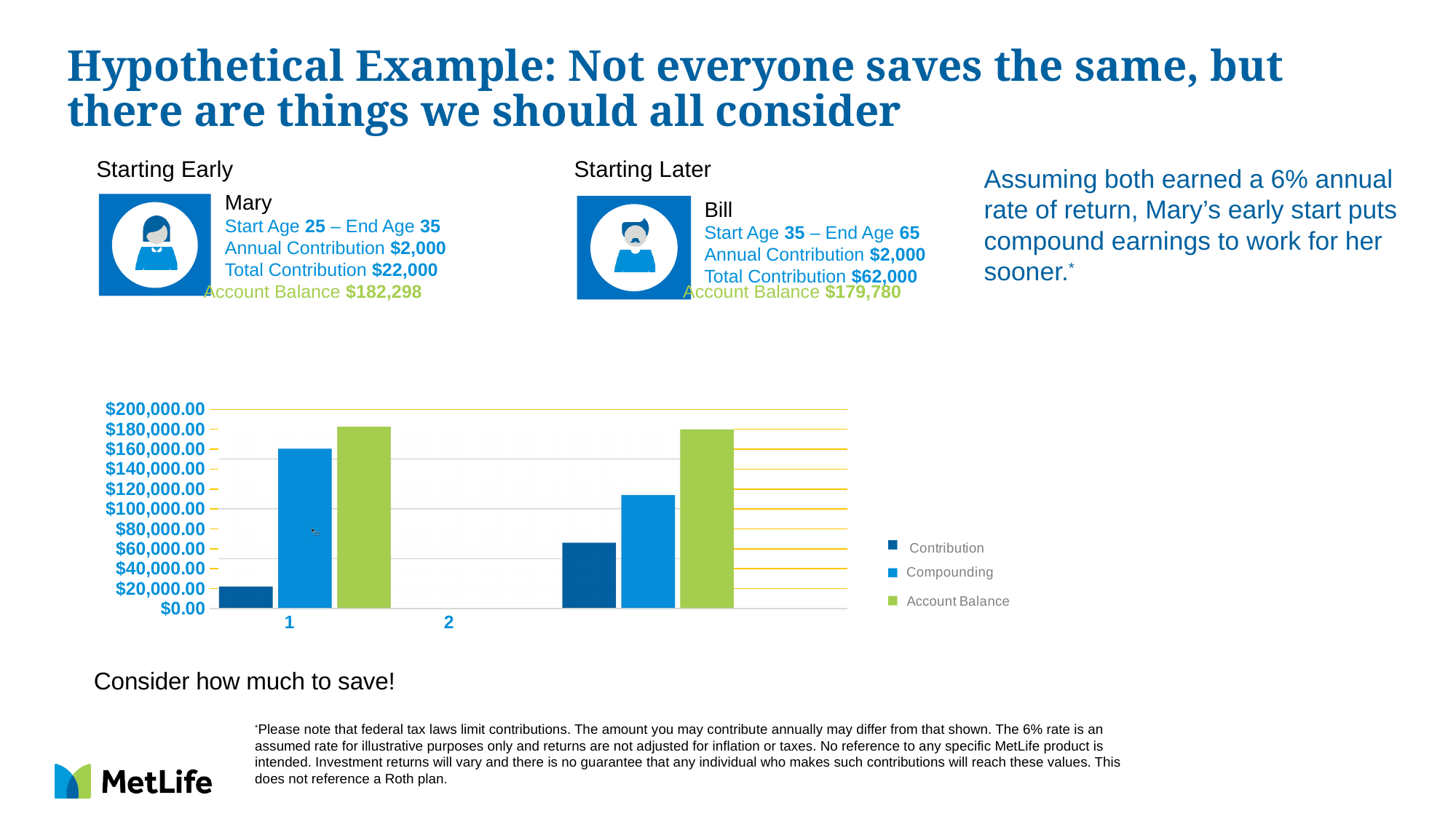
Is the Contribution value for category 1 greater or less than $40,000.00? less Which series has the highest value in category 1? Account Balance How many categories are shown on the x axis of the chart? 2 Is the Compounding value for category 1 greater or less than $140,000.00? greater Which series has the lowest value in category 1? Contribution How many series does the chart legend list? 3 What kind of chart is shown on the slide? bar chart